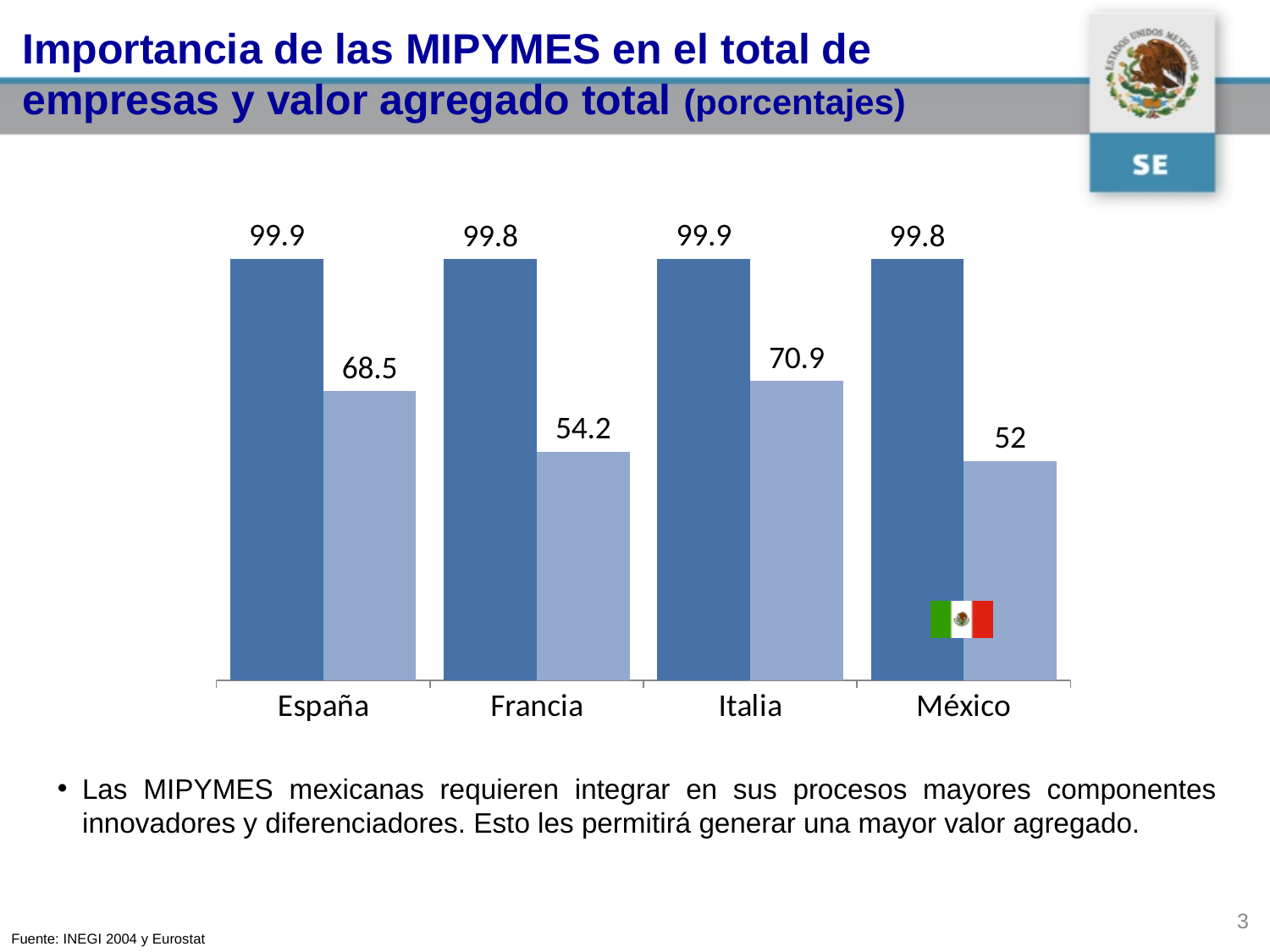
How many countries are shown on the x axis of the chart? 4 Which country has the lowest value for the light blue bar? México What is the difference between the dark blue and light blue bar values for Francia? 45.6 What type of chart is shown on the slide? Bar chart What is the difference between the light blue bar values for Italia and México? 18.9 What is the source cited for the chart data? INEGI 2004 y Eurostat What is the value of the dark blue bar for Francia? 99.8 What is the value of the light blue bar for Italia? 70.9 What is the value of the light blue bar for España? 68.5 Which country has the highest value for the light blue bar? Italia What is the value of the light blue bar for México? 52 Which is larger, the light blue bar for España or the light blue bar for Francia? España